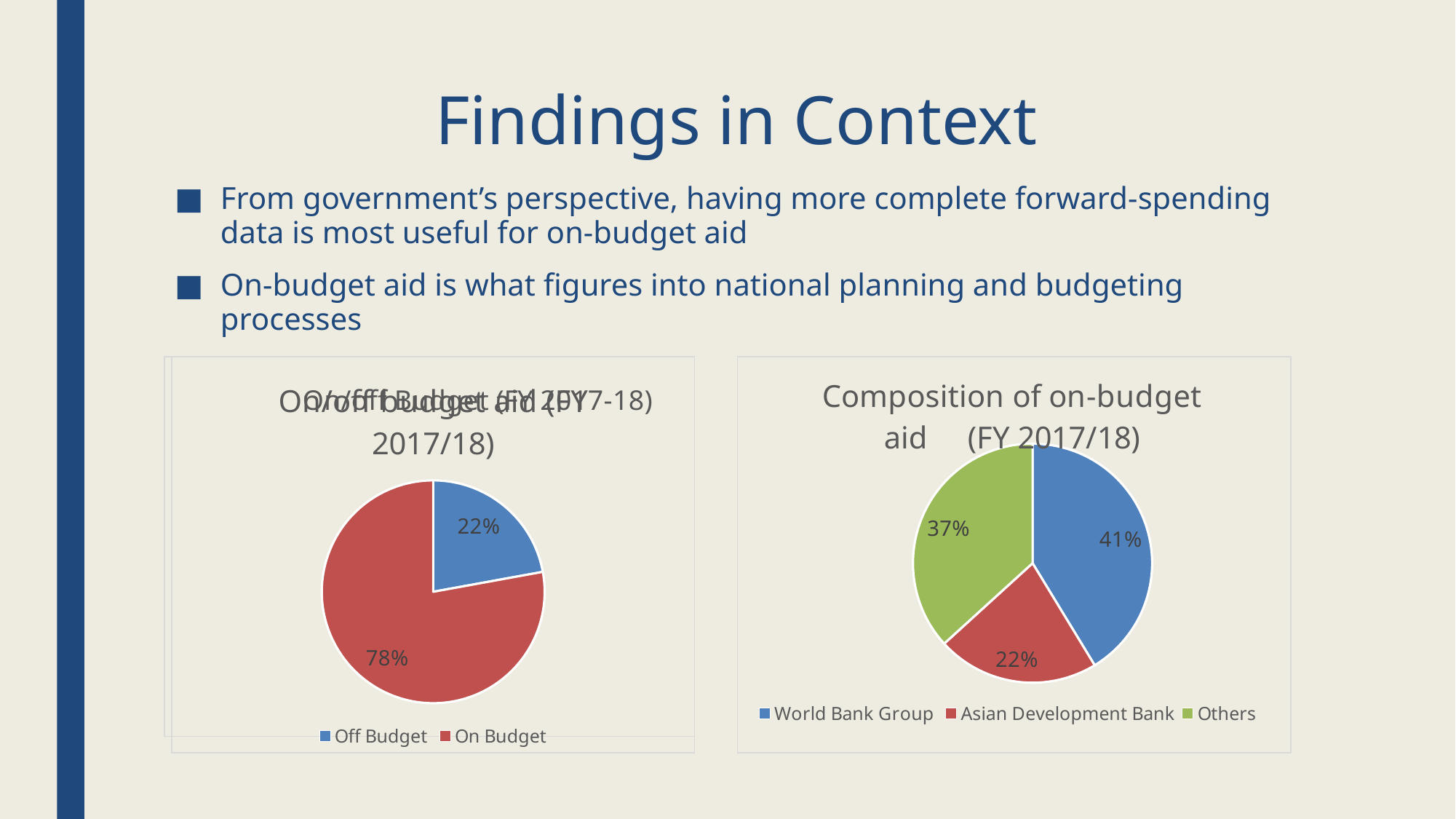
In the left pie chart, which category has the larger slice? On Budget In the chart titled 'Composition of on-budget aid (FY 2017/18)', what share is labelled for Asian Development Bank? 22% How many categories does the legend of the chart titled 'Composition of on-budget aid (FY 2017/18)' list? 3 In the chart titled 'Composition of on-budget aid (FY 2017/18)', what share is labelled for World Bank Group? 41% In the left pie chart, what is the difference in percentage points between On Budget and Off Budget? 56 In the chart titled 'Composition of on-budget aid (FY 2017/18)', which category has the smallest slice? Asian Development Bank In the chart titled 'Composition of on-budget aid (FY 2017/18)', which category has the largest slice? World Bank Group What type of chart is the chart titled 'Composition of on-budget aid (FY 2017/18)'? Pie chart In the left pie chart, what share is labelled for Off Budget? 22% In the chart titled 'Composition of on-budget aid (FY 2017/18)', which is larger: Others or Asian Development Bank? Others In the left pie chart, what share is labelled for On Budget? 78% In the chart titled 'Composition of on-budget aid (FY 2017/18)', what share is labelled for Others? 37%